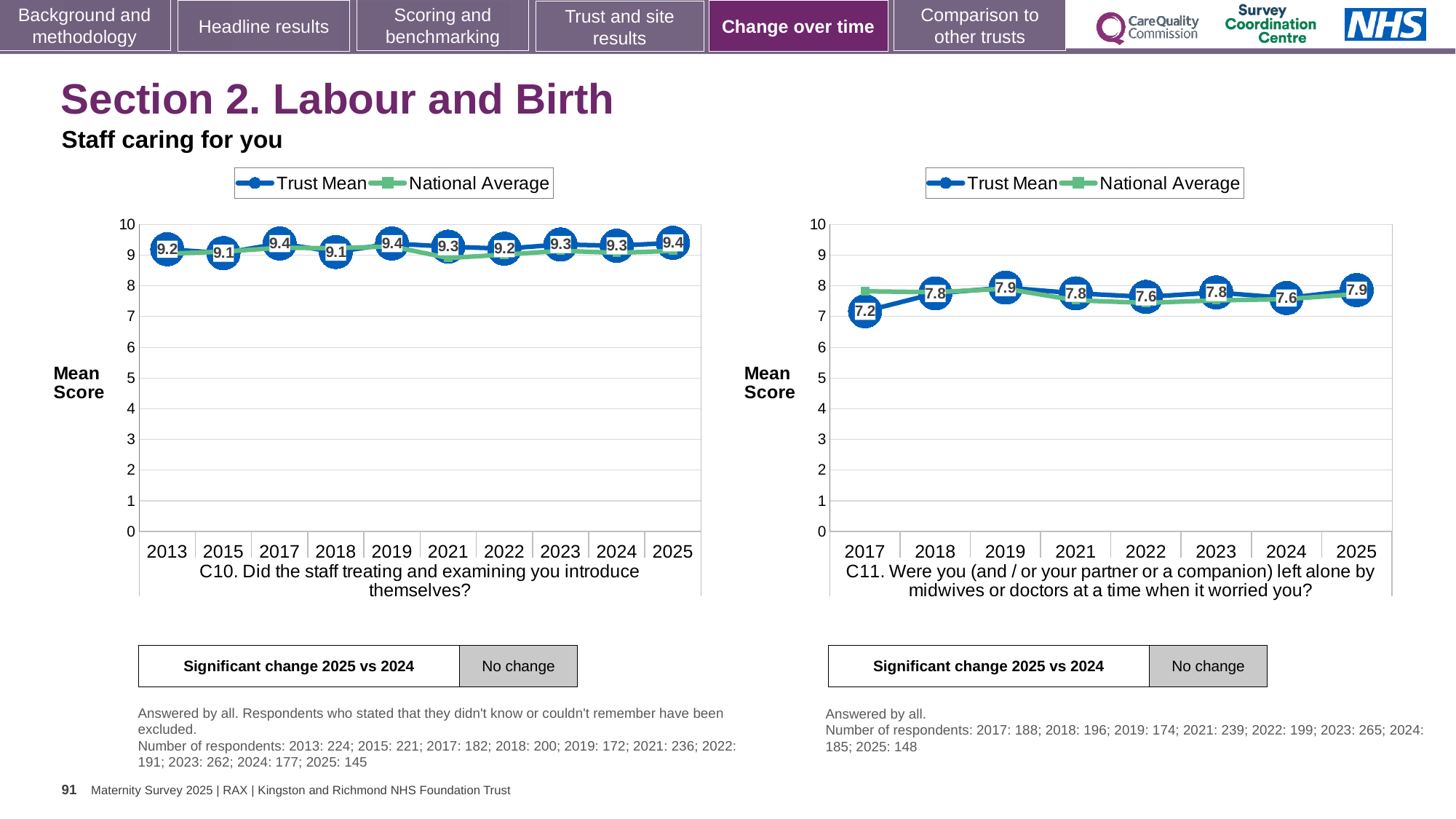
What type of chart is the C10 chart on the left? Line chart In the C10 chart on the left, what is the Trust Mean score for 2013? 9.2 In the C11 chart on the right, is the National Average value for 2017 greater or less than 7? greater In the C10 chart on the left, what is the Trust Mean score for 2025? 9.4 In the C11 chart on the right, what is the difference between the Trust Mean scores for 2025 and 2017? 0.7 In the C11 chart on the right, is the Trust Mean score higher in 2019 or in 2022? 2019 How many series does the legend of the C11 chart on the right list? 2 In the C10 chart on the left, what is the difference between the Trust Mean scores for 2017 and 2018? 0.3 In the C11 chart on the right, what is the Trust Mean score for 2017? 7.2 In the C11 chart on the right, which year has the lowest Trust Mean score? 2017 How many years are plotted on the x axis of the C10 chart on the left? 10 In the C11 chart on the right, what is the Trust Mean score for 2024? 7.6